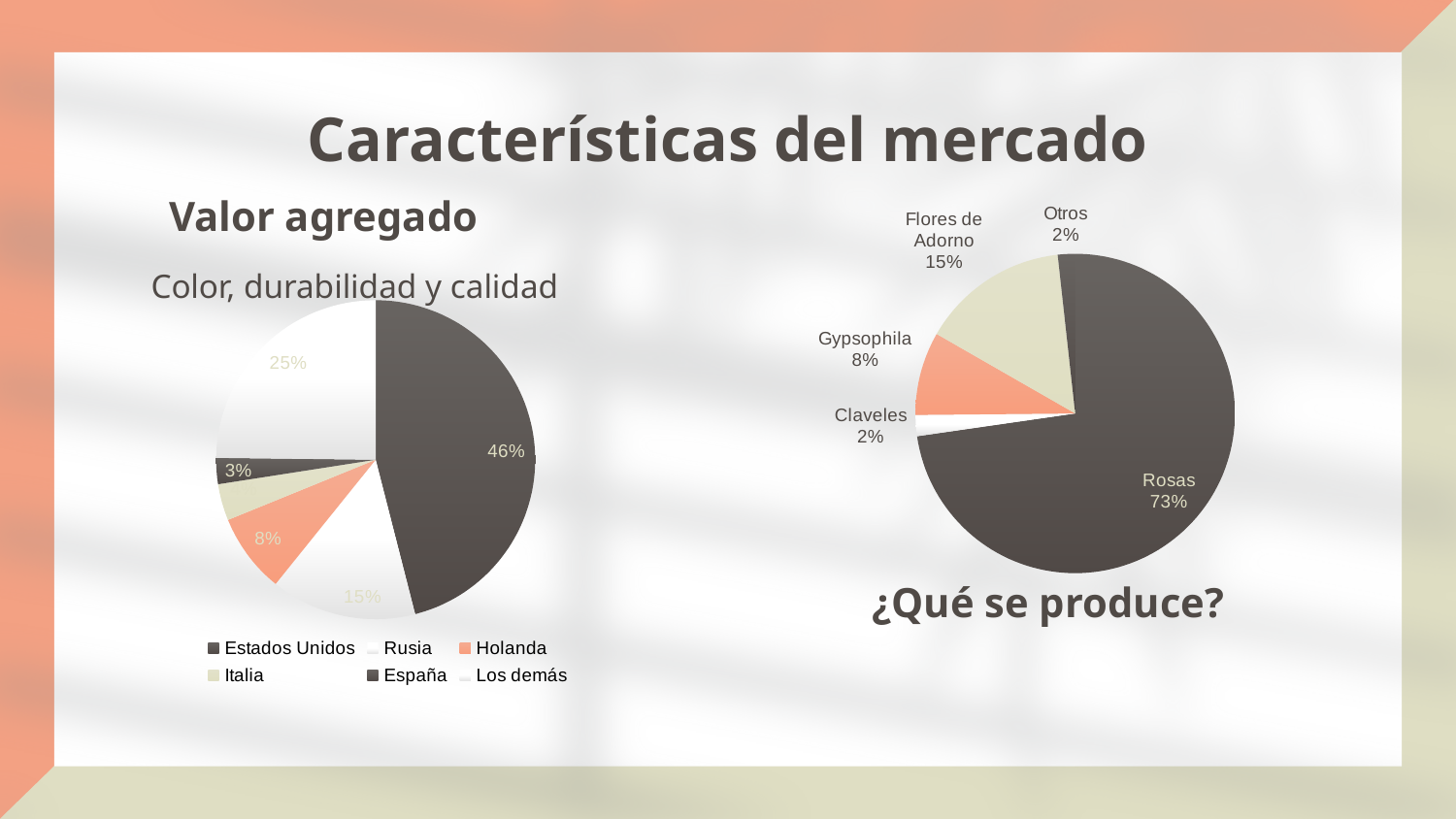
In the '¿Qué se produce?' pie chart, which is larger, Gypsophila or Claveles? Gypsophila In the left pie chart under 'Valor agregado', what percentage is shown for Holanda? 8% In the '¿Qué se produce?' pie chart, how many percentage points larger is Rosas than Flores de Adorno? 58 percentage points What type of chart is used under 'Valor agregado' on the left of the slide? Pie chart How many categories are shown in the '¿Qué se produce?' pie chart? 5 In the '¿Qué se produce?' pie chart, what percentage is shown for Gypsophila? 8% In the left pie chart under 'Valor agregado', which category has the largest share? Estados Unidos In the '¿Qué se produce?' pie chart, what percentage is shown for Flores de Adorno? 15% In the '¿Qué se produce?' pie chart, which category has the largest share? Rosas In the '¿Qué se produce?' pie chart, what percentage is shown for Rosas? 73% How many entries does the legend of the left pie chart under 'Valor agregado' list? 6 In the left pie chart under 'Valor agregado', what percentage is shown for Estados Unidos? 46%